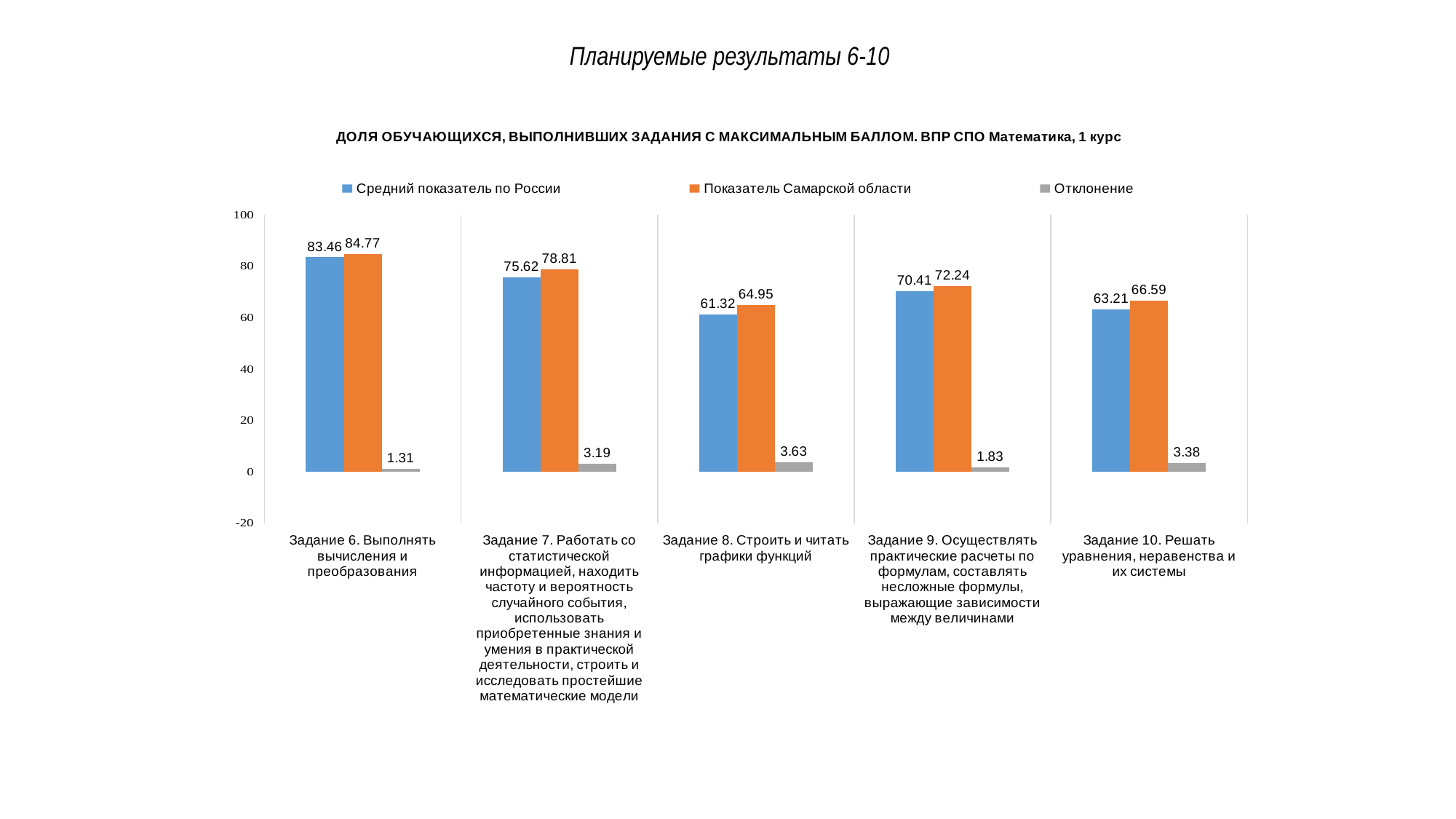
Which colour represents 'Отклонение' in the chart? Grey Which is larger for Задание 9: 'Средний показатель по России' or 'Показатель Самарской области'? Показатель Самарской области How many tasks (categories) are shown on the x axis? 5 Which task has the lowest 'Средний показатель по России' value? Задание 8 What is the difference between 'Показатель Самарской области' and 'Средний показатель по России' for Задание 7? 3.19 What is the value of 'Показатель Самарской области' for Задание 10? 66.59 What is the value of 'Средний показатель по России' for Задание 8? 61.32 What is the 'Отклонение' value for Задание 9? 1.83 Which task has the largest 'Отклонение' value? Задание 8 How many series does the legend list? 3 What kind of chart is shown on the slide? Bar chart Which task has the highest 'Показатель Самарской области' value? Задание 6